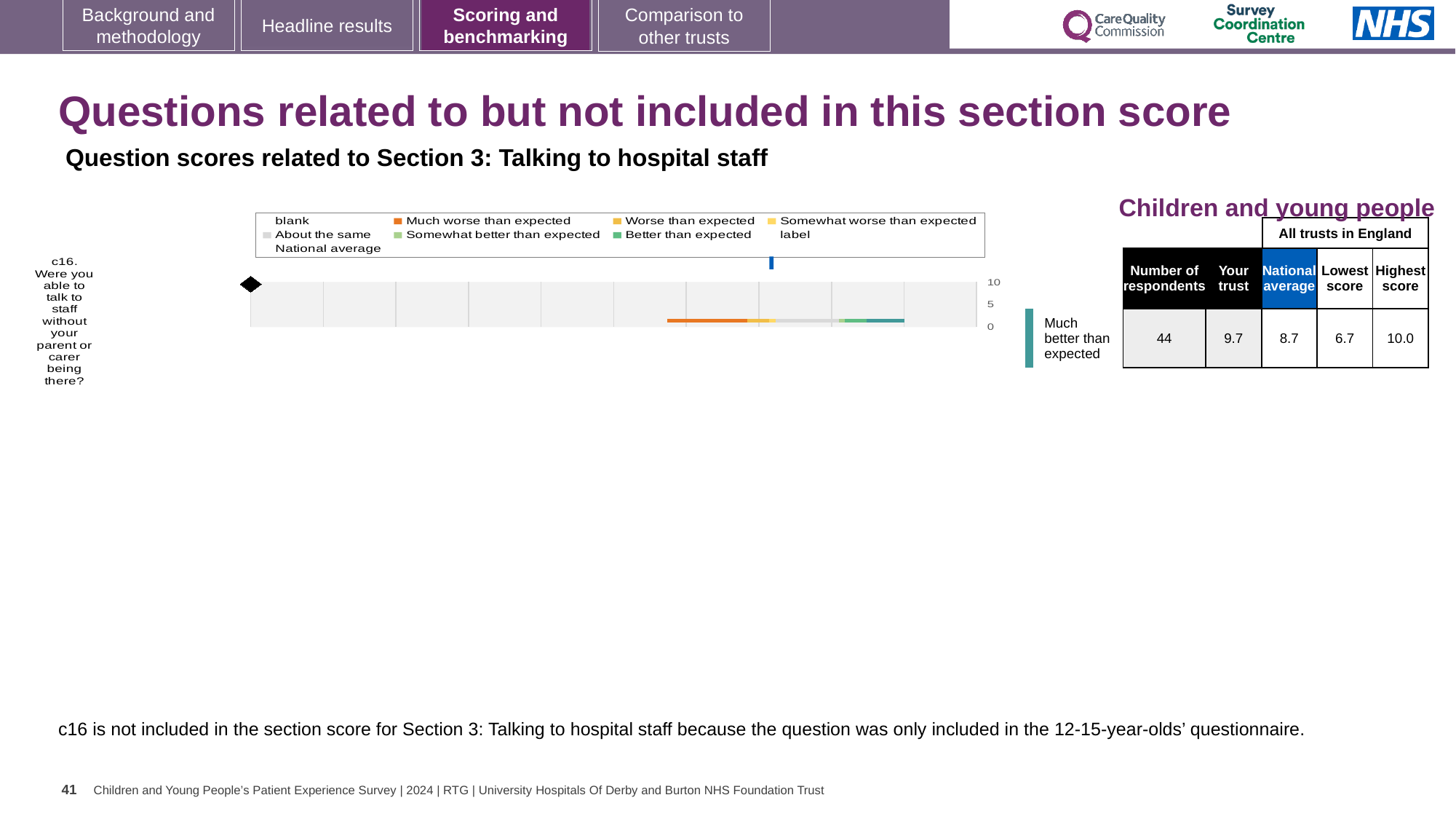
What is the difference between the 'Your trust' score and the National average for c16? 1.0 In the table beside the chart, what is the 'Your trust' score for c16? 9.7 In the table beside the chart, what is the Lowest score across all trusts in England for c16? 6.7 What benchmark rating is shown next to the chart for question c16? Much better than expected What kind of chart is shown for question c16? bar chart Which question code is plotted in the chart? c16 What is the highest tick value shown on the chart's axis? 10 In the table beside the chart, how many respondents answered c16? 44 In the table beside the chart, what is the Highest score across all trusts in England for c16? 10.0 How many survey questions are plotted in the chart? 1 Which is larger for c16: the 'Your trust' score or the National average? Your trust In the table beside the chart, what is the National average score for c16? 8.7